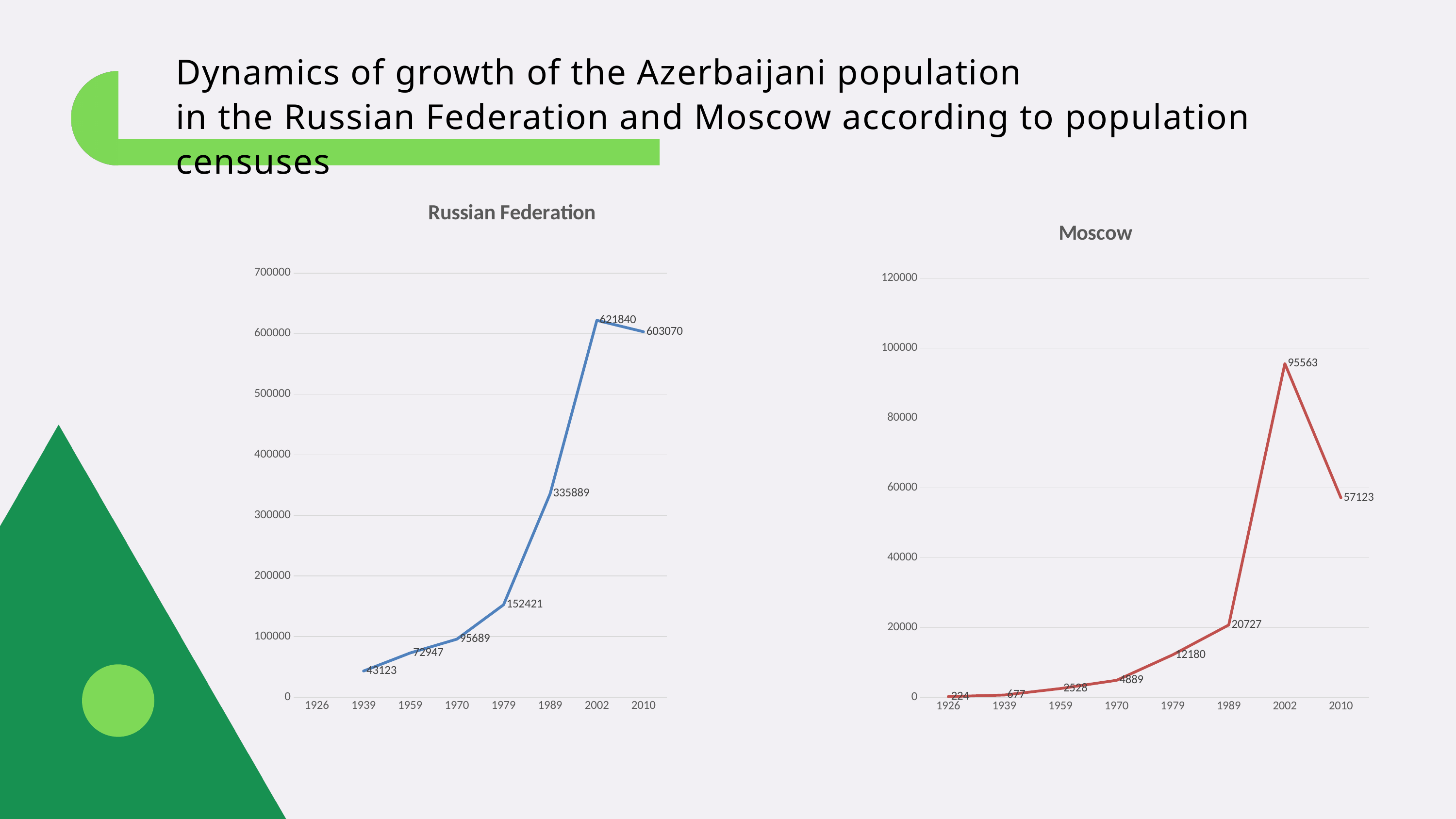
In the Moscow chart, how many data points are plotted? 8 In the Russian Federation chart, what is the value for 1979? 152421 In the Russian Federation chart, what is the difference between the values for 2002 and 2010? 18770 In the Moscow chart, what is the value for 2010? 57123 In the Russian Federation chart, do the values rise or fall from 1939 to 2002? rise What kind of chart is the Russian Federation chart? line chart In the Russian Federation chart, what is the value for 2002? 621840 In the Russian Federation chart, which year has the lowest plotted value? 1939 In the Moscow chart, what is the difference between the values for 2002 and 2010? 38440 In the Moscow chart, what is the value for 1989? 20727 In the Moscow chart, which is larger, the value for 1979 or the value for 1989? 1989 In the Moscow chart, which year has the highest value? 2002